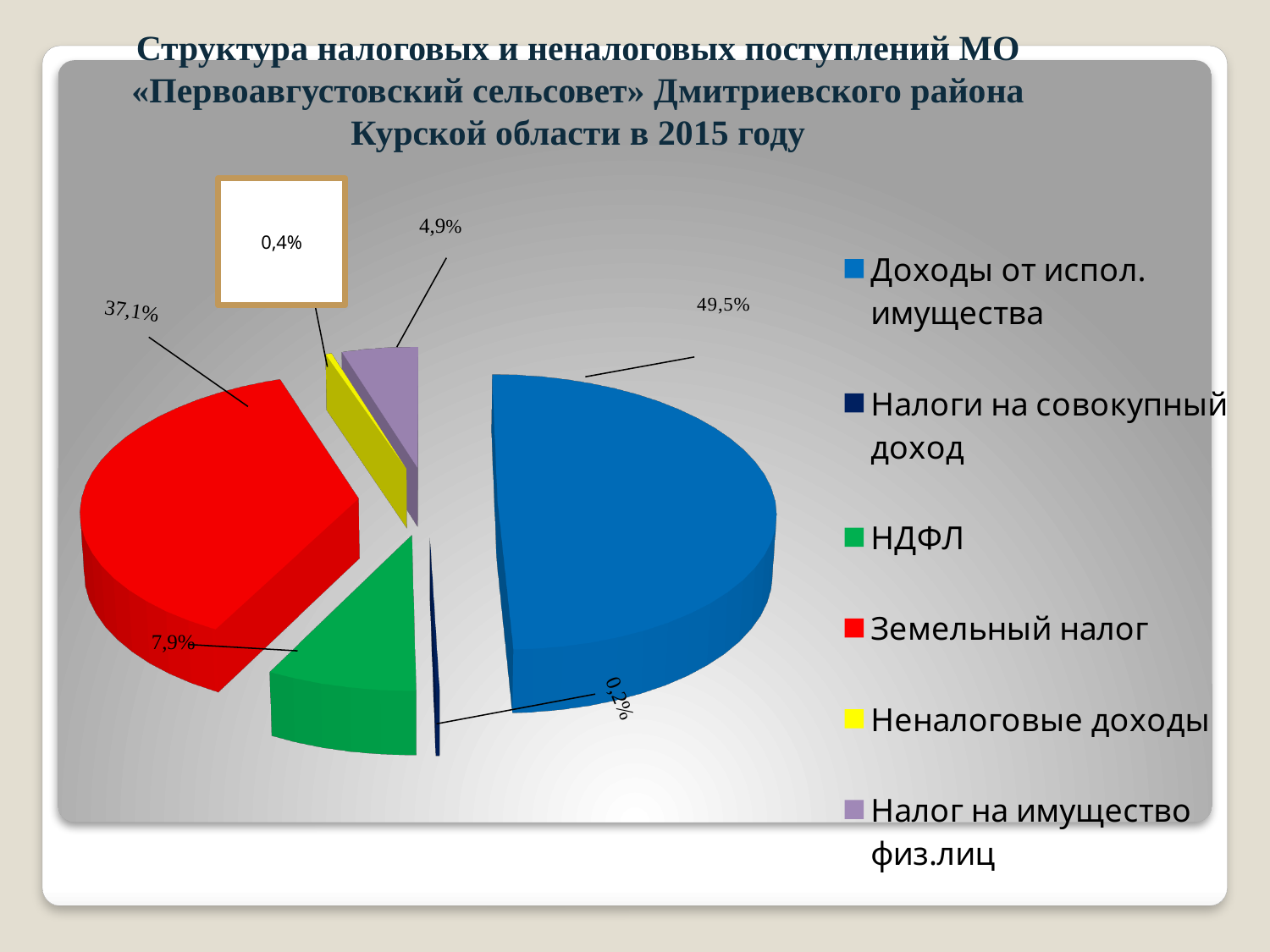
What share of the pie does «Доходы от испол. имущества» have? 49,5% What share of the pie does «Неналоговые доходы» have? 0,4% What share of the pie does «Налоги на совокупный доход» have? 0,2% What share of the pie does «НДФЛ» have? 7,9% Which category has the largest share of the pie? Доходы от испол. имущества What is the difference in percentage points between «Доходы от испол. имущества» and «Земельный налог»? 12,4 What kind of chart is shown on the slide? Pie chart Which category has the smallest share of the pie? Налоги на совокупный доход How many categories does the legend list? 6 What share of the pie does «Налог на имущество физ.лиц» have? 4,9% Which colour represents «НДФЛ» in the pie chart? Green What share of the pie does «Земельный налог» have? 37,1%